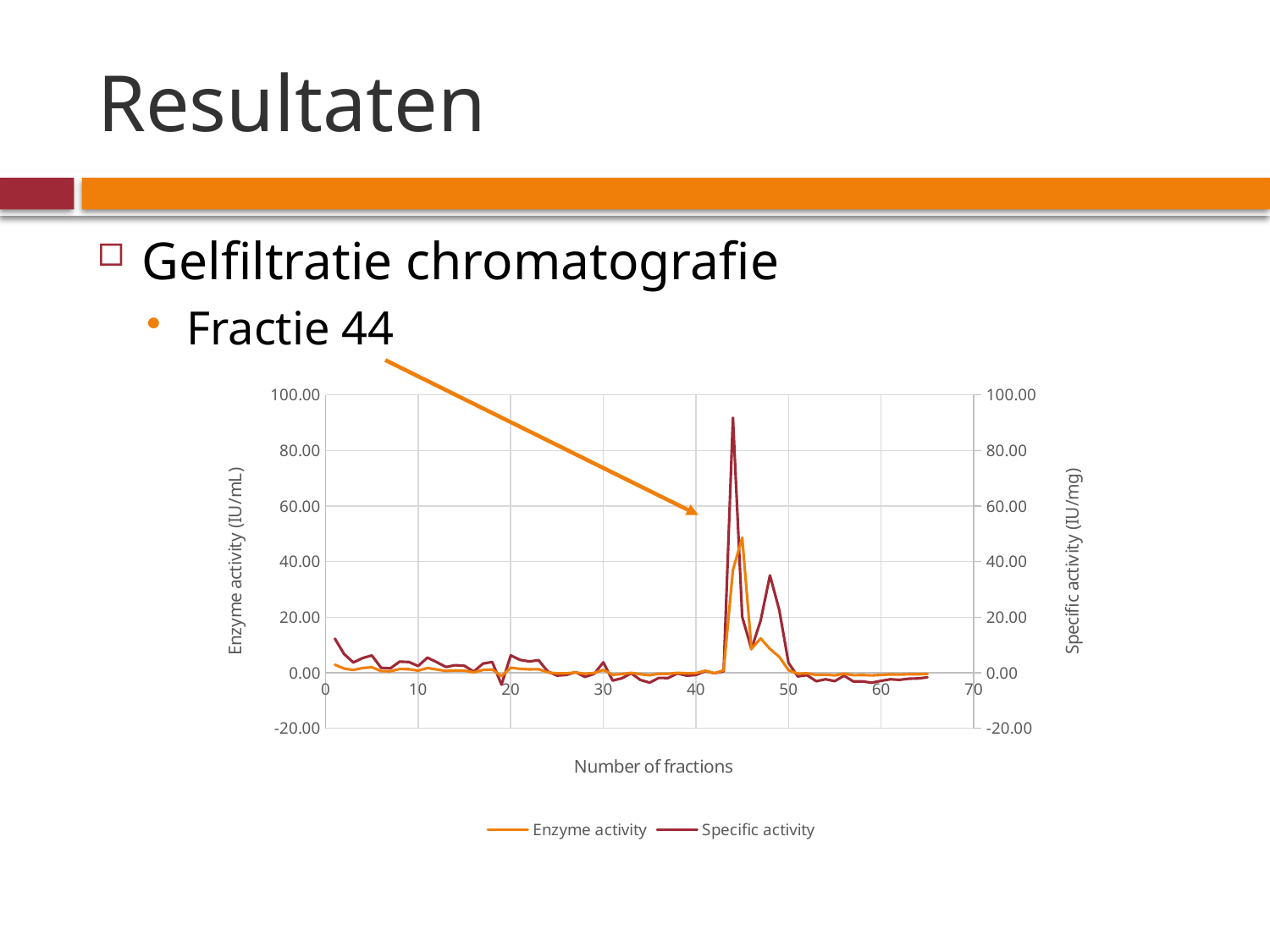
What kind of chart is shown on the slide? line chart What is the title of the x axis of the chart? Number of fractions Is the Specific activity value at fraction 10 greater or less than 20.00? less Is the peak value of the Enzyme activity series greater or less than 60.00? less Is the second peak of the Specific activity series, near fraction 48, greater or less than 20.00? greater What is the highest value shown on the left y axis of the chart? 100.00 What are the two series named in the chart's legend? Enzyme activity and Specific activity How many series does the chart's legend list? 2 Which series reaches the higher peak value, Enzyme activity or Specific activity? Specific activity